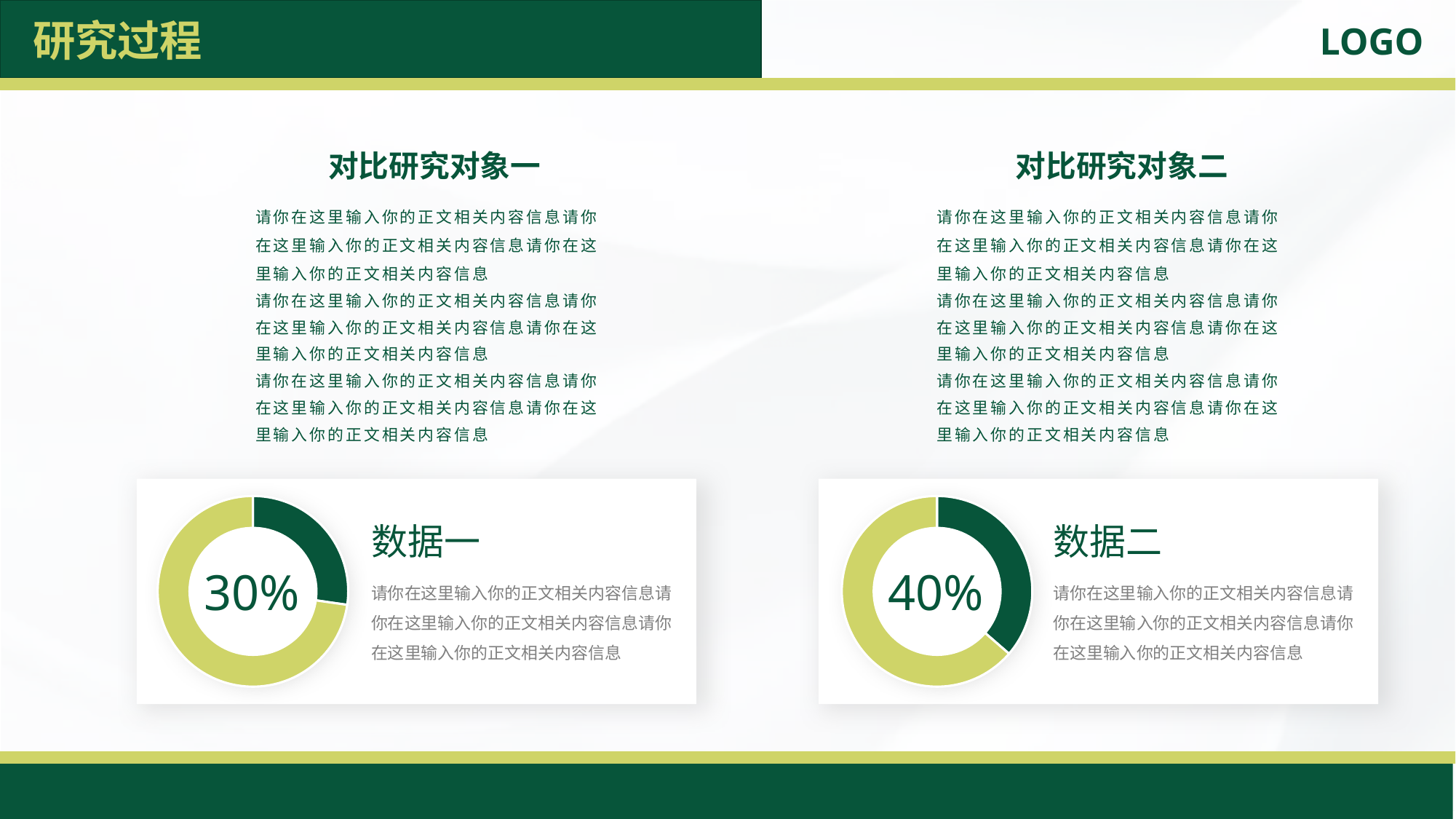
Is the value shown in the 数据一 chart greater or less than 50%? less How many segments does each donut chart on the slide have? 2 What percentage is shown in the centre of the right donut chart labelled 数据二? 40% What kind of chart is used to display the 数据一 value? Donut (pie) chart Which chart shows the larger percentage, 数据一 or 数据二? 数据二 What percentage is shown in the centre of the left donut chart labelled 数据一? 30% What is the difference between the percentage shown for 数据二 and the percentage shown for 数据一? 10% How many donut charts are on the slide? 2 What colour is the segment representing the stated percentage in both donut charts? Dark green Is the value shown in the 数据二 chart greater or less than 50%? less